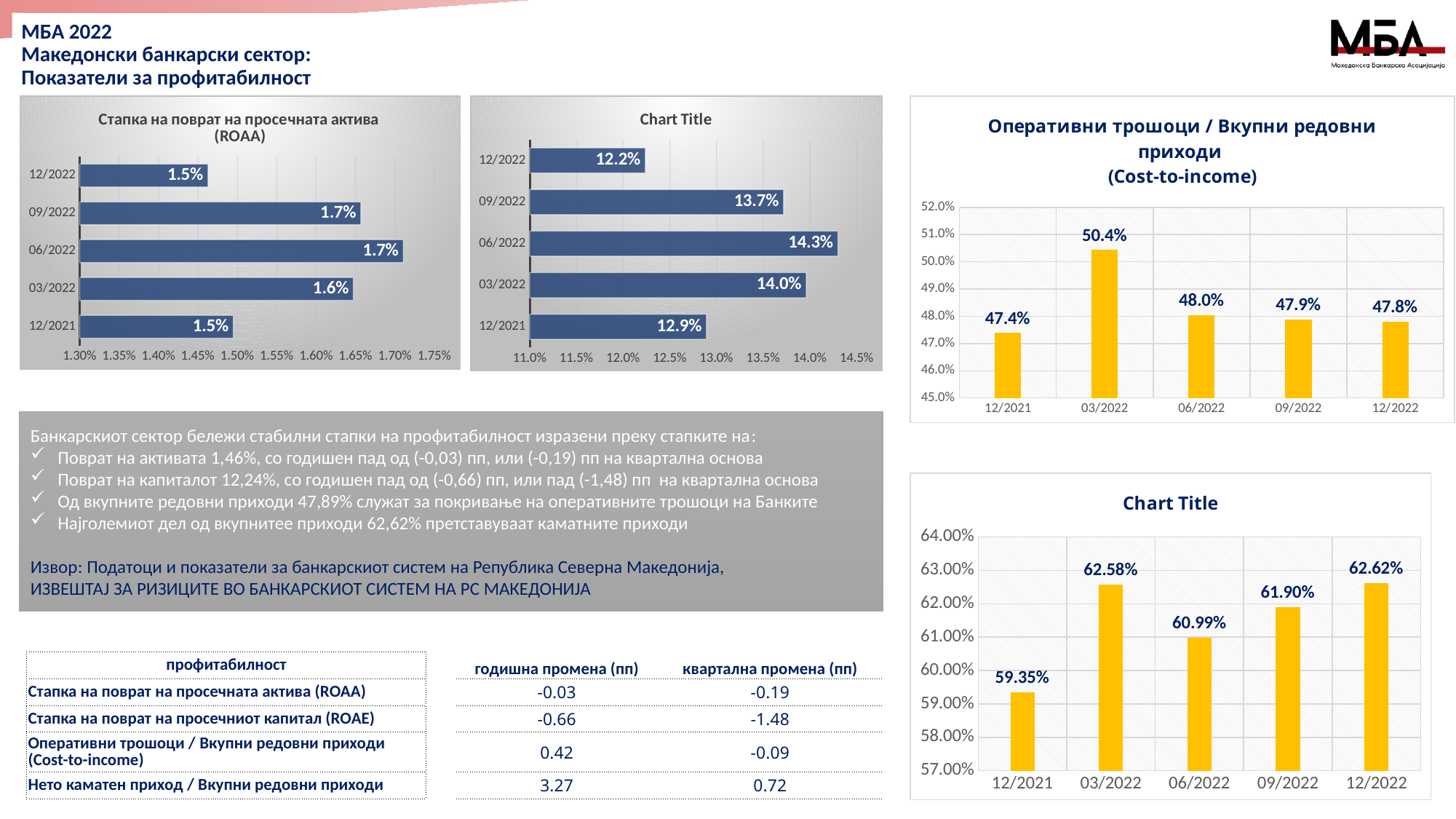
In the horizontal bar chart in the top middle (titled 'Chart Title'), what is the value for 06/2022? 14.3% In the vertical bar chart at the bottom right (titled 'Chart Title'), what is the value for 12/2021? 59.35% What type of chart is the Cost-to-income chart at the top right? Bar chart In the ROAA chart at the top left, how many periods are plotted? 5 In the horizontal bar chart in the top middle (titled 'Chart Title'), which period has the lowest value? 12/2022 In the horizontal bar chart in the top middle (titled 'Chart Title'), what is the difference between the values for 06/2022 and 12/2022? 2.1% In the Cost-to-income chart at the top right, what is the value for 03/2022? 50.4% In the Cost-to-income chart at the top right, which period has the highest value? 03/2022 In the vertical bar chart at the bottom right (titled 'Chart Title'), which is larger, the value for 03/2022 or the value for 09/2022? 03/2022 In the ROAA chart at the top left, what is the value for 03/2022? 1.6% In the vertical bar chart at the bottom right (titled 'Chart Title'), what is the difference between the values for 12/2022 and 12/2021? 3.27% In the Cost-to-income chart at the top right, is the value for 12/2021 greater or less than 48.0%? less